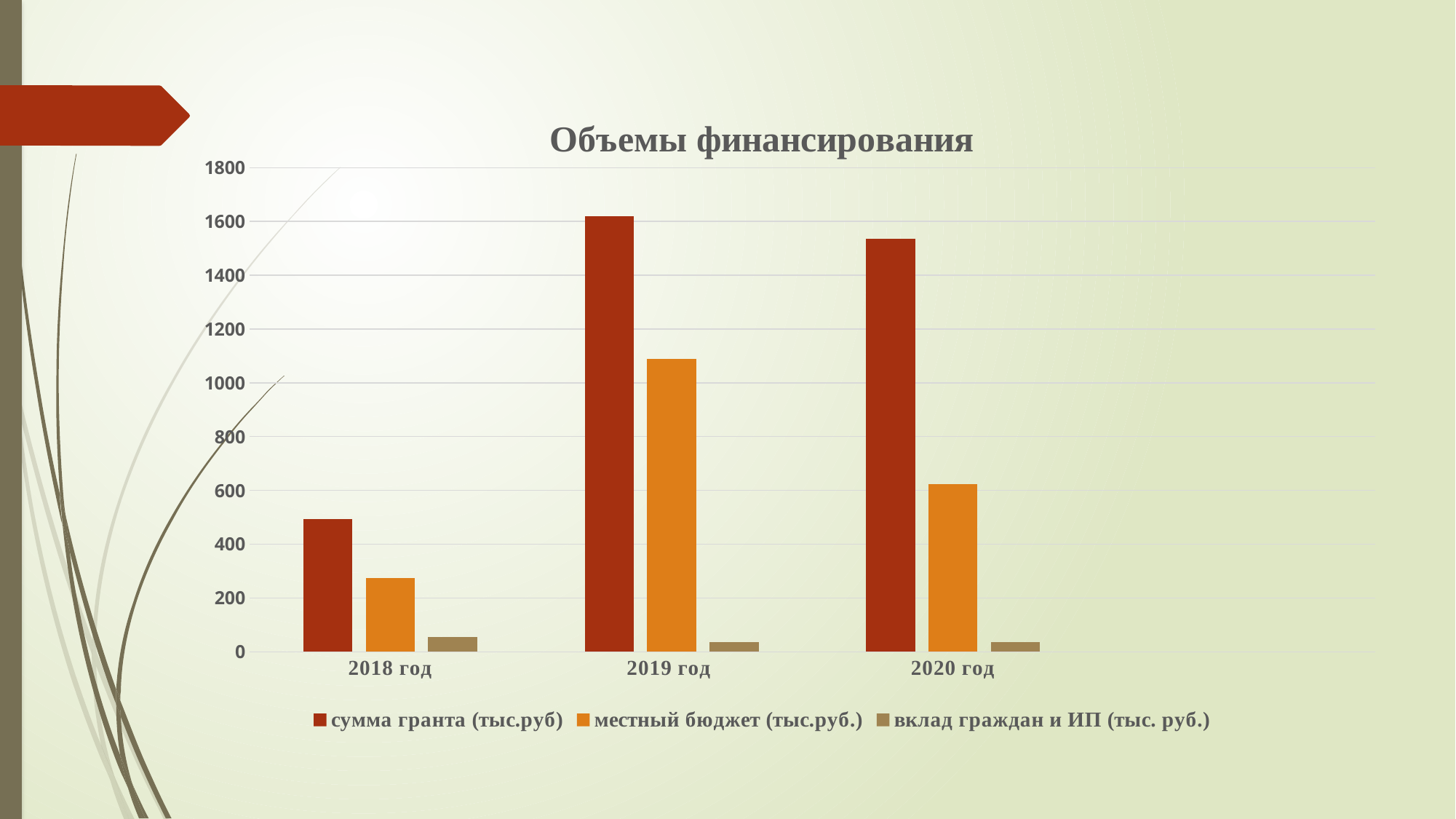
What kind of chart is shown on the slide? bar chart Is the value for местный бюджет (тыс.руб.) in 2020 год greater or less than 600? greater Which series is shown in orange in the legend? местный бюджет (тыс.руб.) Does the value for местный бюджет (тыс.руб.) rise or fall from 2018 год to 2019 год? rise Which year has the highest value for сумма гранта (тыс.руб)? 2019 год Which is larger in 2020 год: сумма гранта (тыс.руб) or местный бюджет (тыс.руб.)? сумма гранта (тыс.руб) What is the title of the chart? Объемы финансирования How many year categories are shown on the x axis? 3 Is the value for сумма гранта (тыс.руб) in 2019 год greater or less than 1600? greater Is the value for сумма гранта (тыс.руб) in 2018 год greater or less than 600? less Which year has the lowest value for местный бюджет (тыс.руб.)? 2018 год How many series does the legend list? 3